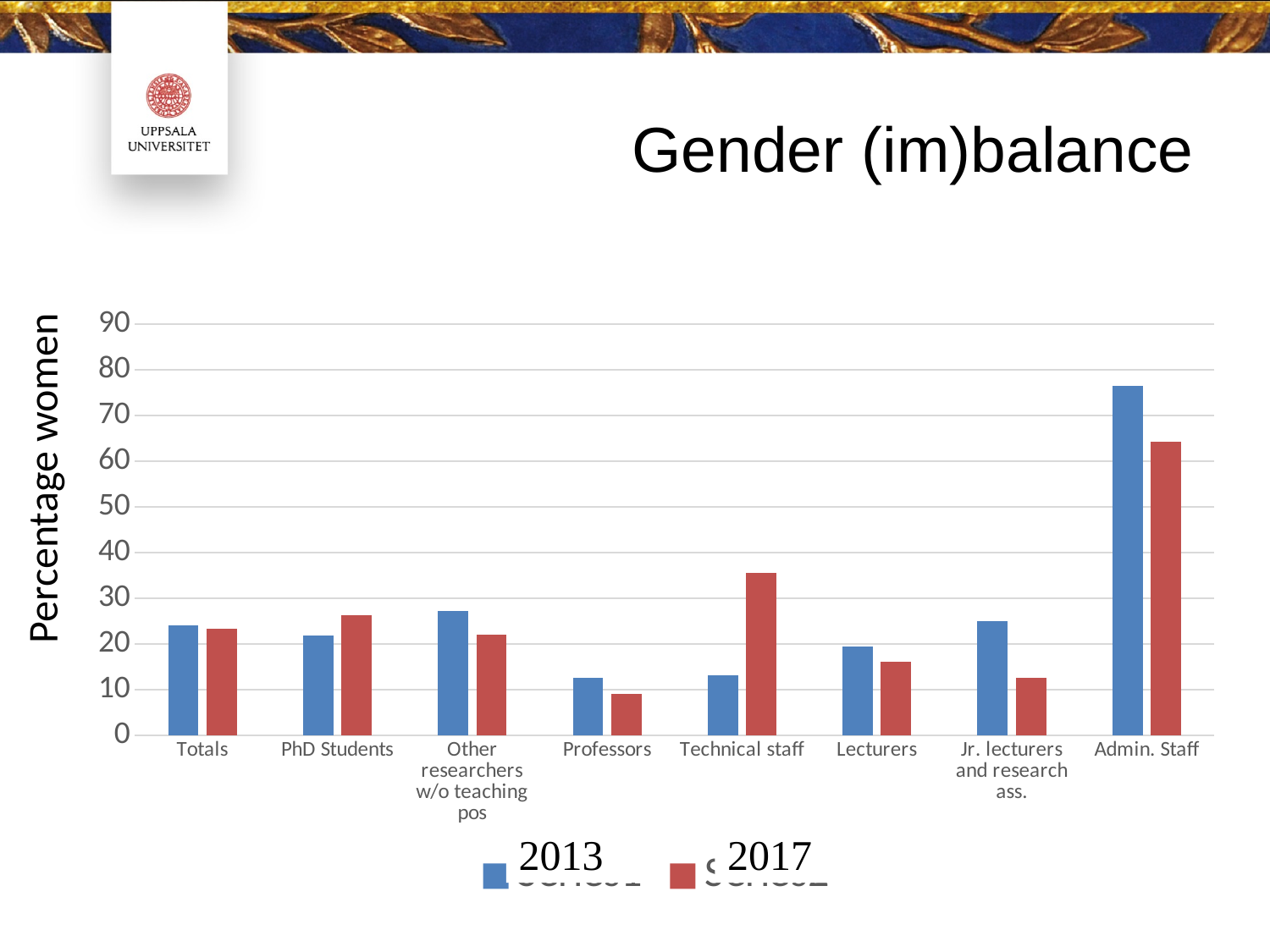
Which category has the lowest value for 2017? Professors How many categories are shown on the x axis of the chart? 8 Is the value for Professors in 2017 greater or less than 10? less Is the value for Technical staff in 2017 greater or less than 30? greater How many series does the chart's legend list? 2 For Jr. lecturers and research ass., which year has the larger value, 2013 or 2017? 2013 Is the value for Admin. Staff in 2013 greater or less than 70? greater For Technical staff, which year has the larger value, 2013 or 2017? 2017 What kind of chart is shown on the slide? bar chart What is the label on the y axis of the chart? Percentage women Which category has the highest value for 2013? Admin. Staff What is the title of the slide containing the chart? Gender (im)balance